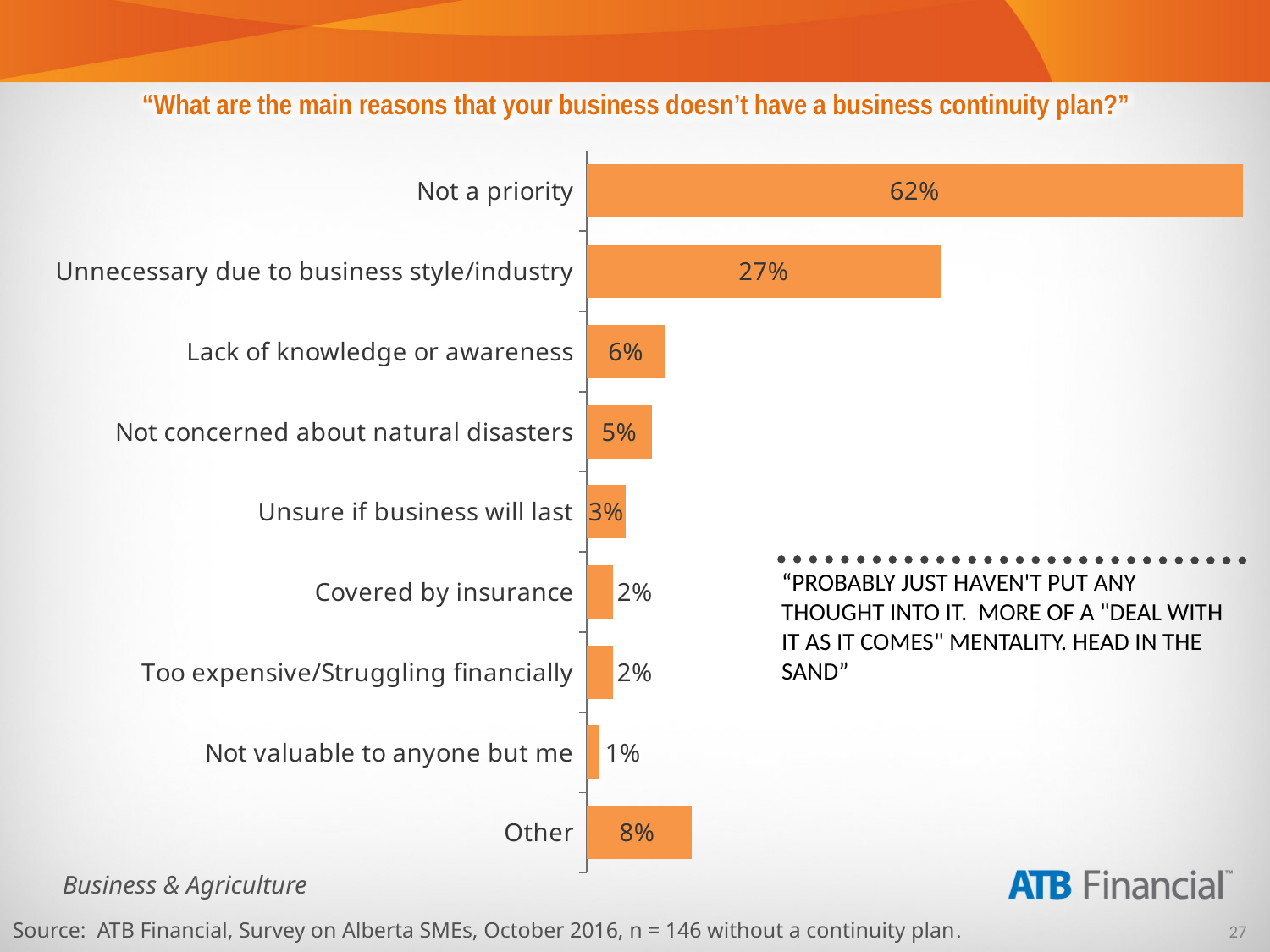
What is the value for 'Unnecessary due to business style/industry'? 27% What is the difference between 'Not a priority' and 'Unnecessary due to business style/industry'? 35% Which reason has the lowest percentage? Not valuable to anyone but me What is the difference between 'Other' and 'Lack of knowledge or awareness'? 2% Which reason has the highest percentage? Not a priority What is the value for 'Other'? 8% Which is larger: 'Not concerned about natural disasters' or 'Unsure if business will last'? Not concerned about natural disasters What colour are the bars in the chart? Orange What percentage of respondents said 'Not a priority'? 62% How many reasons (categories) are shown in the chart? 9 What kind of chart is shown on the slide? Bar chart What percentage is shown for 'Lack of knowledge or awareness'? 6%